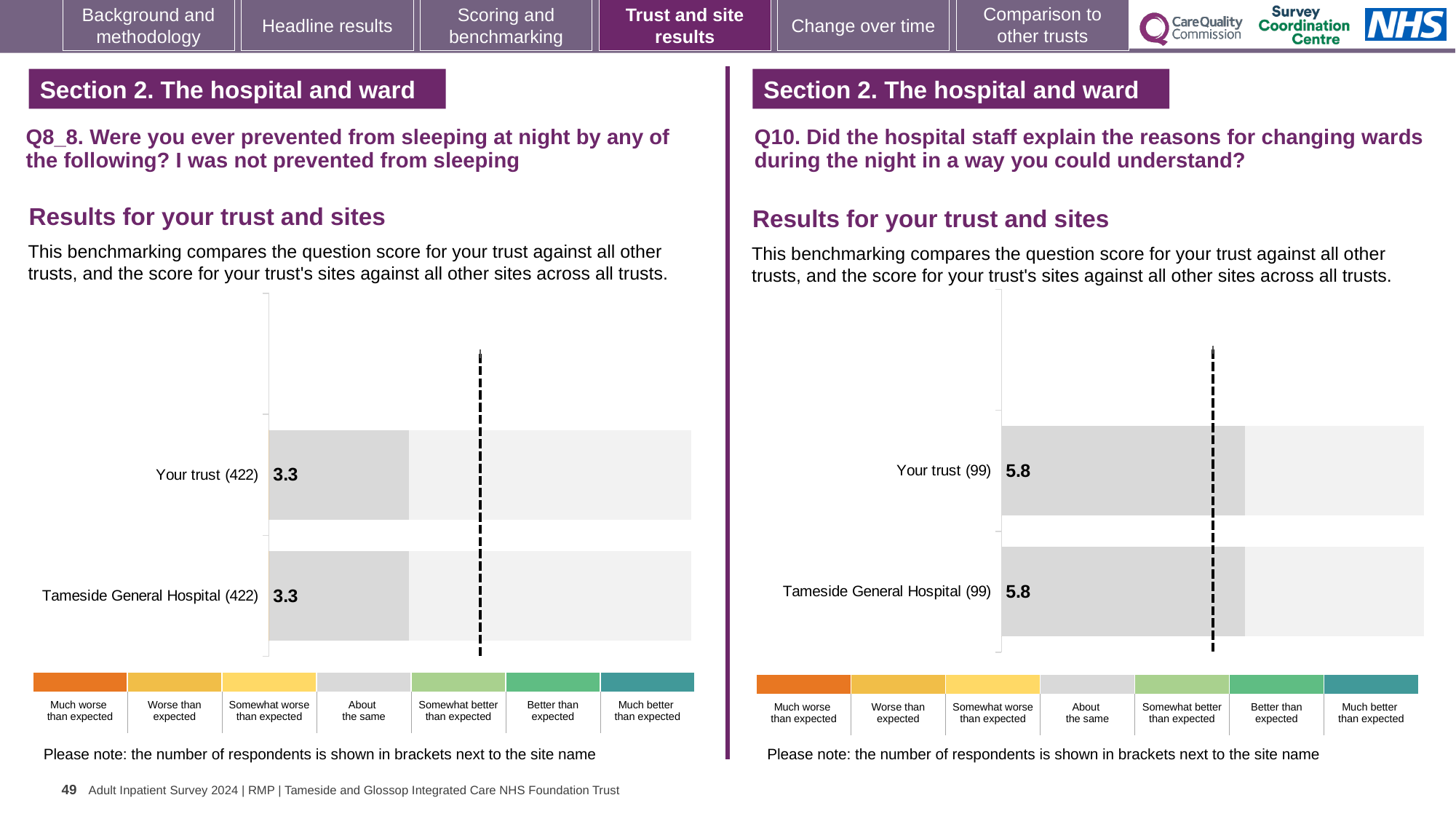
In the left chart (Q8_8), how many respondents are shown in brackets next to Your trust? 422 In the right chart (Q10), what is the score for Tameside General Hospital? 5.8 In the right chart (Q10), how many respondents are shown in brackets next to Tameside General Hospital? 99 Is the score for Your trust in the right chart (Q10) larger or smaller than the score for Your trust in the left chart (Q8_8)? Larger In the left chart (Q8_8), what is the score for Your trust? 3.3 In the right chart (Q10), what is the difference between the score for Your trust and the score for Tameside General Hospital? 0 What kind of chart is the left chart (Q8_8)? Bar chart In the left chart (Q8_8), what is the difference between the score for Your trust and the score for Tameside General Hospital? 0 How many bars are plotted in the right chart (Q10)? 2 In the left chart (Q8_8), what is the score for Tameside General Hospital? 3.3 In the right chart (Q10), what is the score for Your trust? 5.8 How many bars are plotted in the left chart (Q8_8)? 2